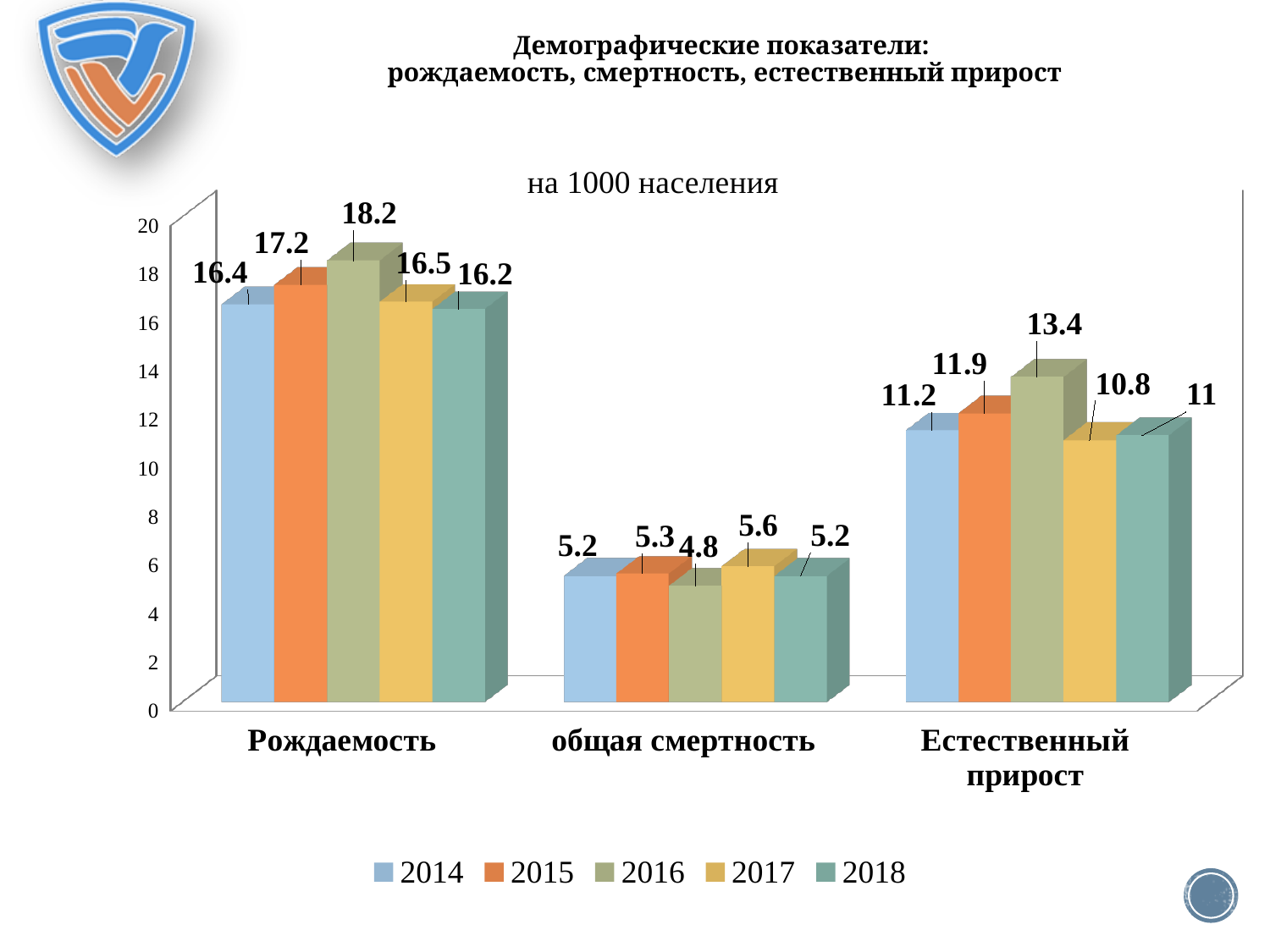
What is the value for Естественный прирост in 2018? 11 What is the difference between the Рождаемость values for 2016 and 2014? 1.8 How many series does the legend list? 5 Which year has the lowest value for общая смертность? 2016 Which is larger: Естественный прирост in 2015 or in 2017? 2015 What is the chart's title? на 1000 населения What is the difference between the общая смертность values for 2017 and 2016? 0.8 What kind of chart is shown on the slide? bar chart How many categories are shown on the x axis? 3 Which year has the highest value for Естественный прирост? 2016 What is the value for общая смертность in 2017? 5.6 What is the value for Рождаемость in 2016? 18.2